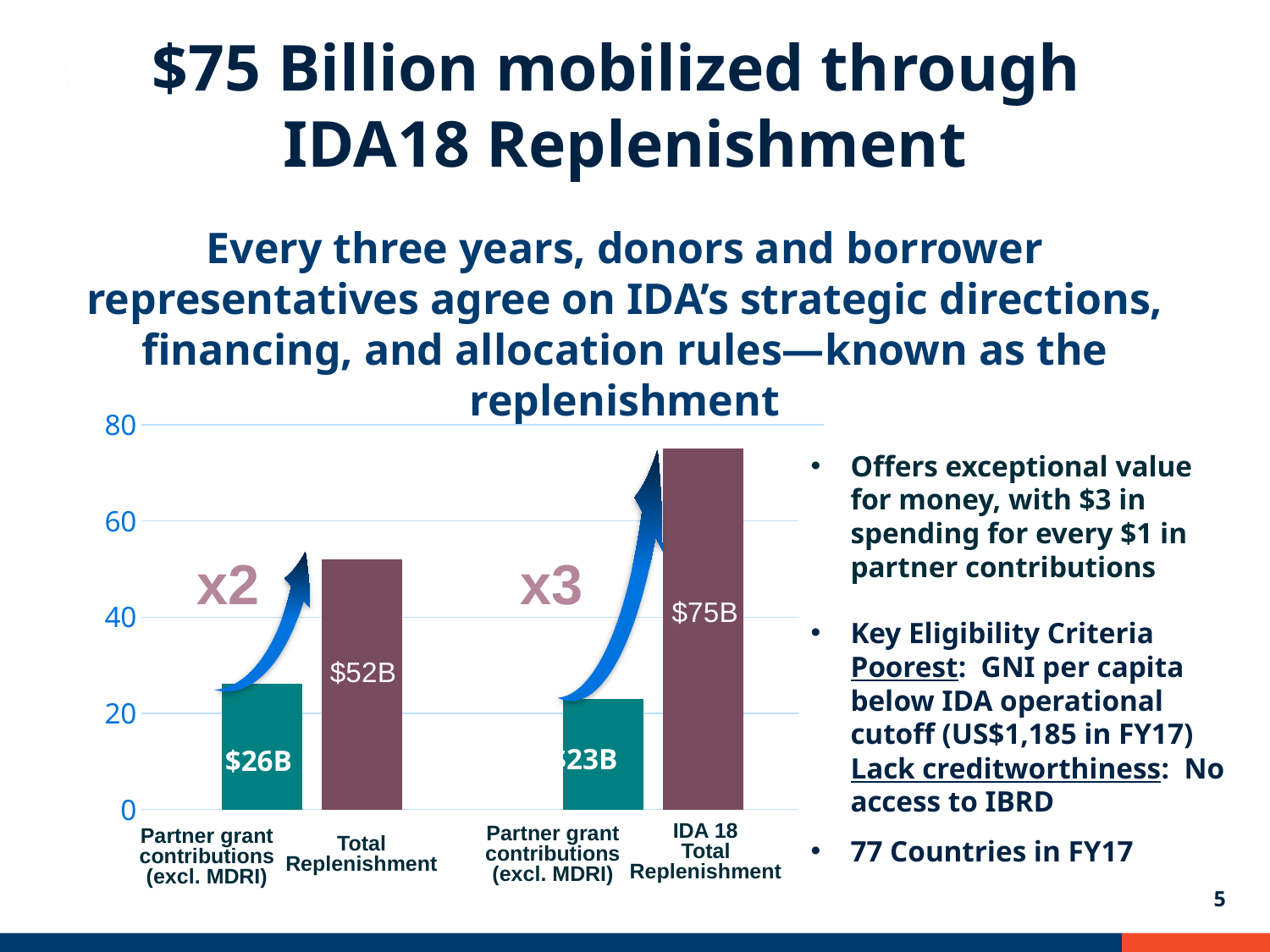
What kind of chart is shown on the slide? bar chart Is the value for IDA 18 Total Replenishment greater or less than 60? greater How many bars are plotted in the chart? 4 Which is larger, the Total Replenishment in the left pair or the IDA 18 Total Replenishment? IDA 18 Total Replenishment What is the value of the IDA 18 Total Replenishment bar? $75B Which bar has the lowest value? Partner grant contributions (excl. MDRI) for IDA 18 (the right-hand one) What is the value of the left-hand Partner grant contributions (excl. MDRI) bar? $26B What is the difference between the IDA 18 Total Replenishment and the earlier Total Replenishment? $23B What is the value of the Partner grant contributions (excl. MDRI) bar next to the IDA 18 Total Replenishment bar? $23B What is the difference between the left-hand Total Replenishment bar and the left-hand Partner grant contributions (excl. MDRI) bar? $26B Which bar has the highest value? IDA 18 Total Replenishment What is the value of the Total Replenishment bar in the left pair of bars? $52B